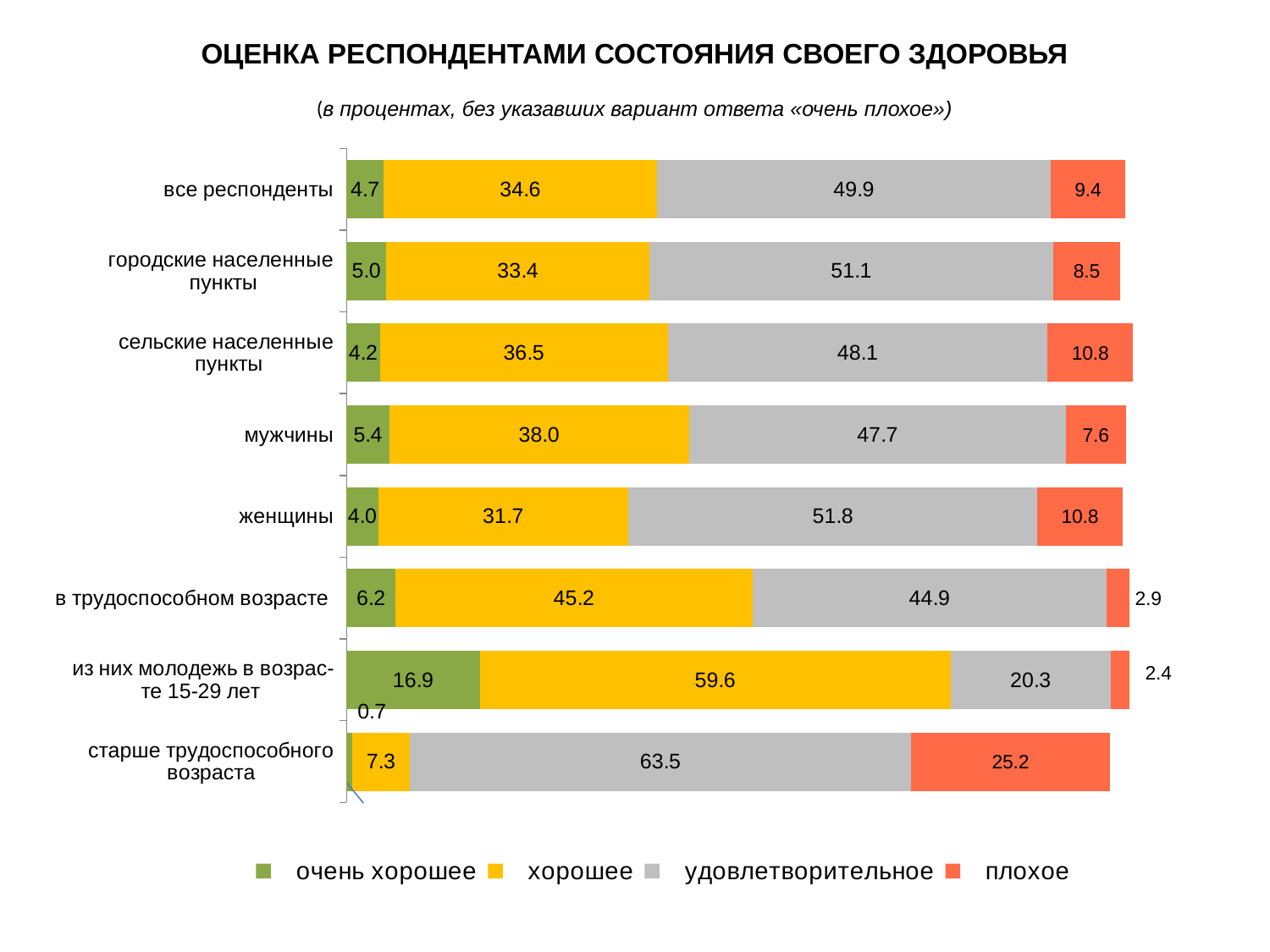
Which category has the lowest value for «очень хорошее»? старше трудоспособного возраста What is the value of «хорошее» for «мужчины»? 38.0 How many series does the legend list? 4 What is the value of «удовлетворительное» for «старше трудоспособного возраста»? 63.5 What is the total of the stacked bar for «все респонденты»? 98.6 How many categories are plotted on the chart? 8 What is the value of «очень хорошее» for «из них молодежь в возрасте 15-29 лет»? 16.9 What is the difference between the «плохое» values for «старше трудоспособного возраста» and «из них молодежь в возрасте 15-29 лет»? 22.8 Which category has the highest value for «плохое»? старше трудоспособного возраста What kind of chart is shown on the slide? stacked bar chart Which series is shown in grey in the legend? удовлетворительное Which has the larger «удовлетворительное» value, «мужчины» or «женщины»? женщины